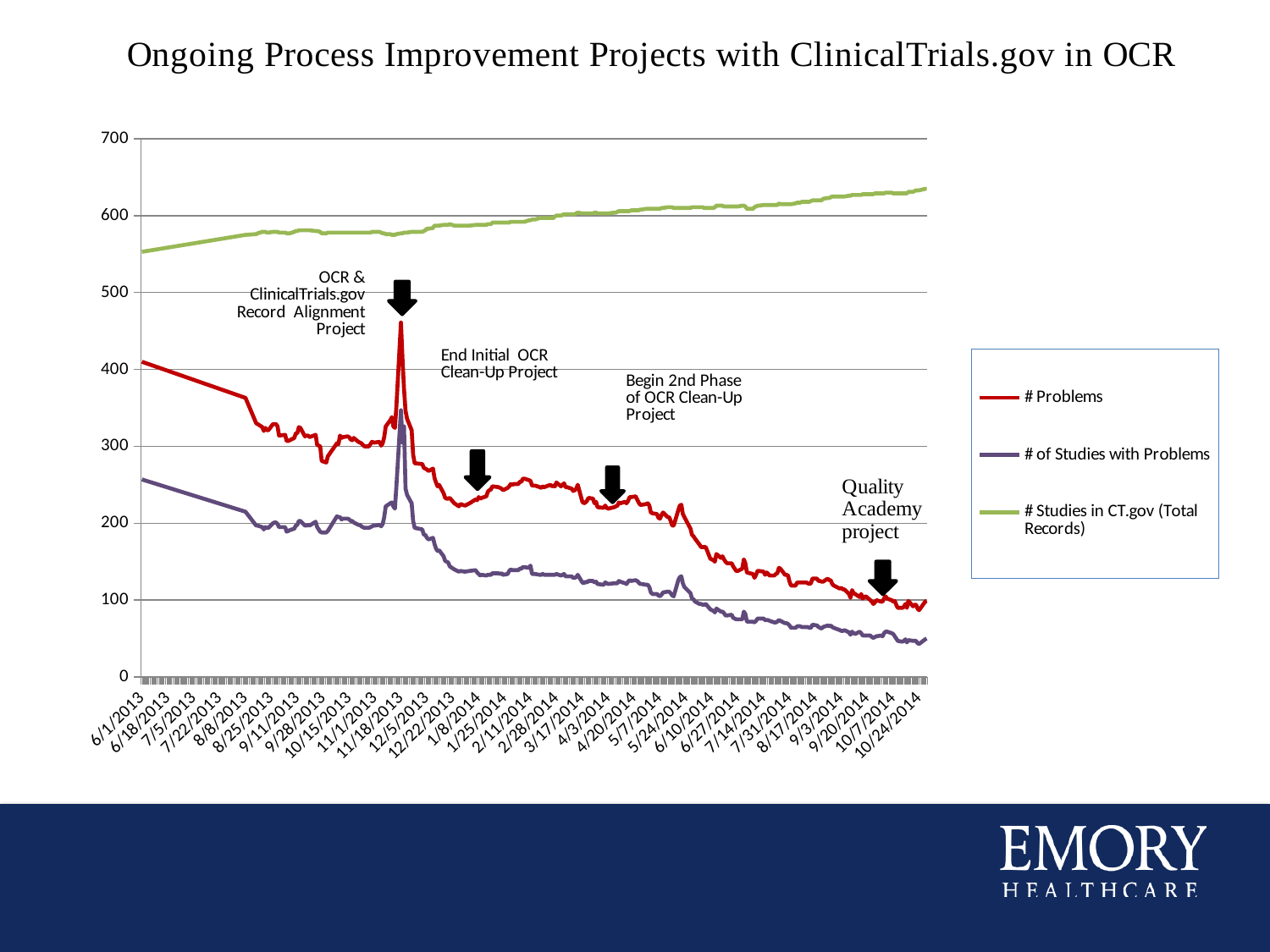
Which series has the highest values throughout the chart? # Studies in CT.gov (Total Records) What kind of chart is shown on the slide? line chart Does the "# Studies in CT.gov (Total Records)" series rise or fall from 6/1/2013 to 10/24/2014? rise Is the value for "# Studies in CT.gov (Total Records)" at 10/24/2014 greater or less than 600? greater How many series does the legend list? 3 Does the "# of Studies with Problems" series rise or fall overall from 6/1/2013 to 10/24/2014? fall Which series has the lowest values at 10/24/2014? # of Studies with Problems Is the value for "# of Studies with Problems" at 10/24/2014 greater or less than 100? less Which colour is used for the "# Problems" series? red What is the title of the slide's chart? Ongoing Process Improvement Projects with ClinicalTrials.gov in OCR Does the "# Problems" series rise or fall overall from 6/1/2013 to 10/24/2014? fall Is the peak value of "# Problems" near 11/18/2013 greater or less than 400? greater